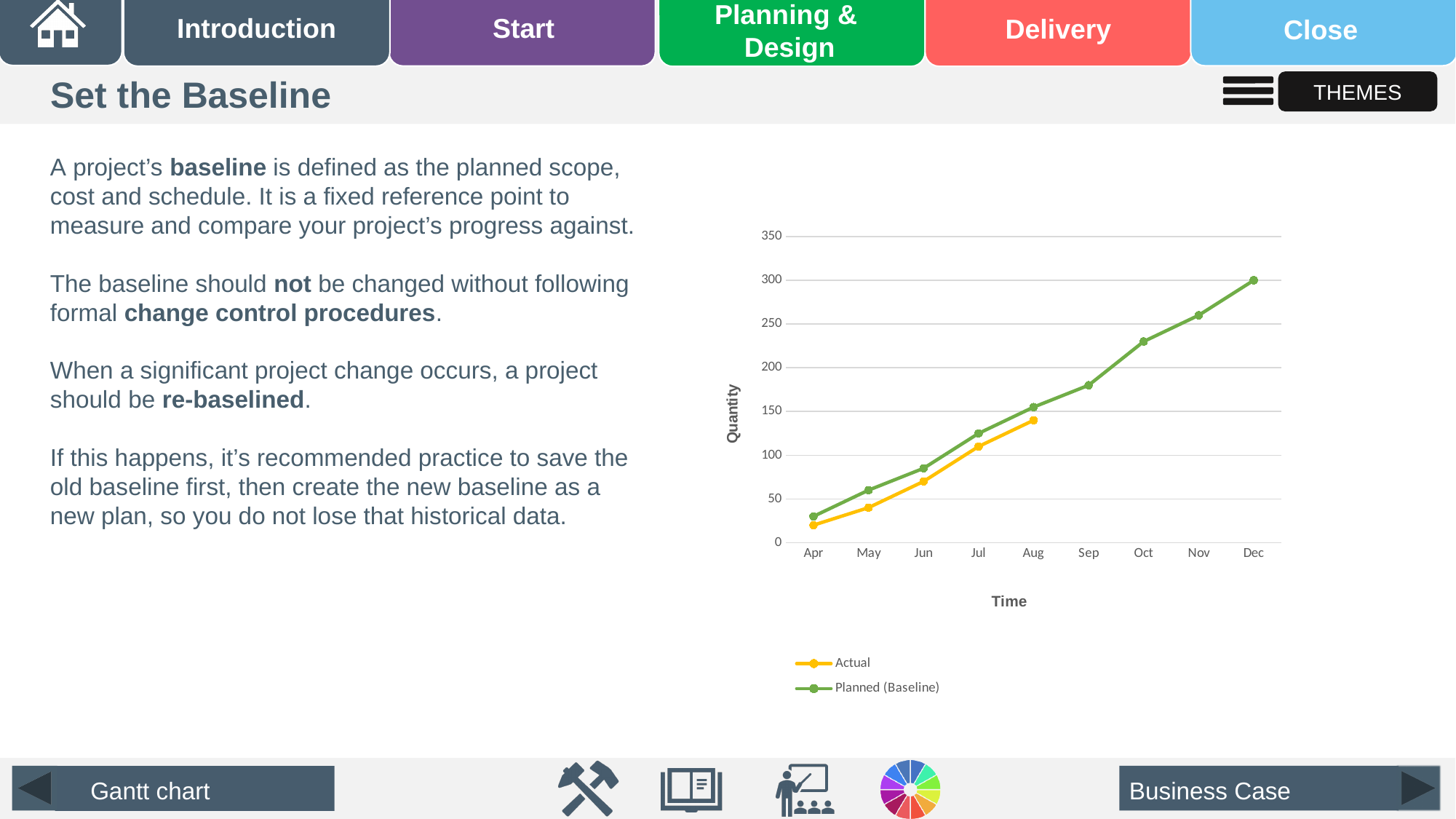
How many series does the chart's legend list? 2 Is the Planned (Baseline) value for Sep greater or less than 200? less In which month does the Planned (Baseline) series reach its highest value? Dec Do the Planned (Baseline) values rise or fall from Apr to Dec? rise Is the Planned (Baseline) value for Nov greater or less than 250? greater In Aug, which series has the higher value, Actual or Planned (Baseline)? Planned (Baseline) How many months are shown along the x axis of the chart? 9 Is the Actual value for Apr greater or less than 50? less What is the Planned (Baseline) value for Dec? 300 What kind of chart is shown on the slide? line chart What is the title of the vertical axis of the chart? Quantity